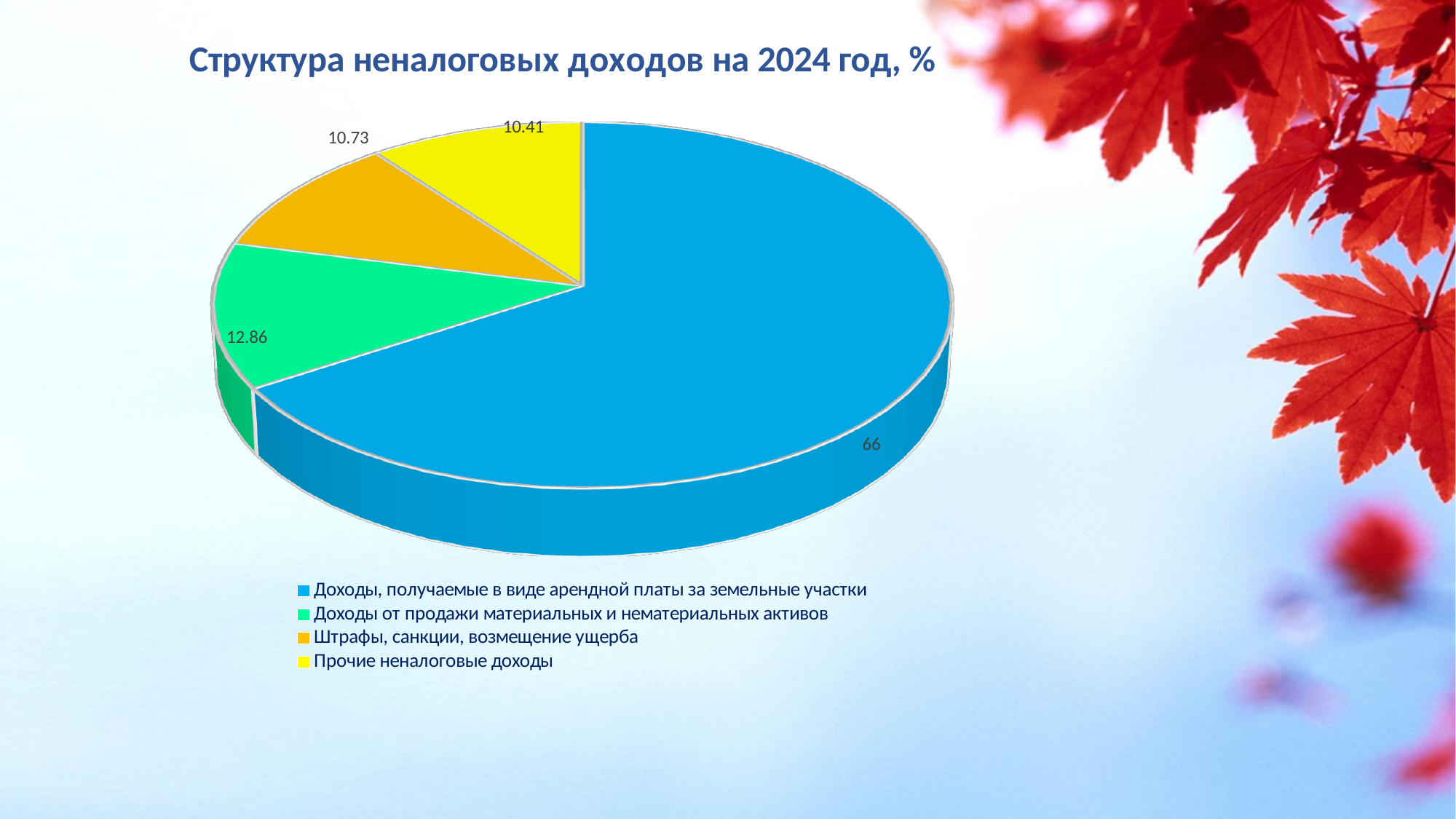
What is the title of the chart? Структура неналоговых доходов на 2024 год, % Which is larger: the value for "Штрафы, санкции, возмещение ущерба" or for "Прочие неналоговые доходы"? Штрафы, санкции, возмещение ущерба Which category has the largest share of the pie? Доходы, получаемые в виде арендной платы за земельные участки What is the value for "Штрафы, санкции, возмещение ущерба"? 10.73 What is the value for "Доходы от продажи материальных и нематериальных активов"? 12.86 What colour is the slice for "Прочие неналоговые доходы"? Yellow How many categories does the pie chart have? 4 What type of chart is shown on the slide? Pie chart Which category has the smallest share of the pie? Прочие неналоговые доходы What is the value for "Доходы, получаемые в виде арендной платы за земельные участки"? 66 What is the difference between the values for "Доходы, получаемые в виде арендной платы за земельные участки" and "Доходы от продажи материальных и нематериальных активов"? 53.14 What is the value for "Прочие неналоговые доходы"? 10.41